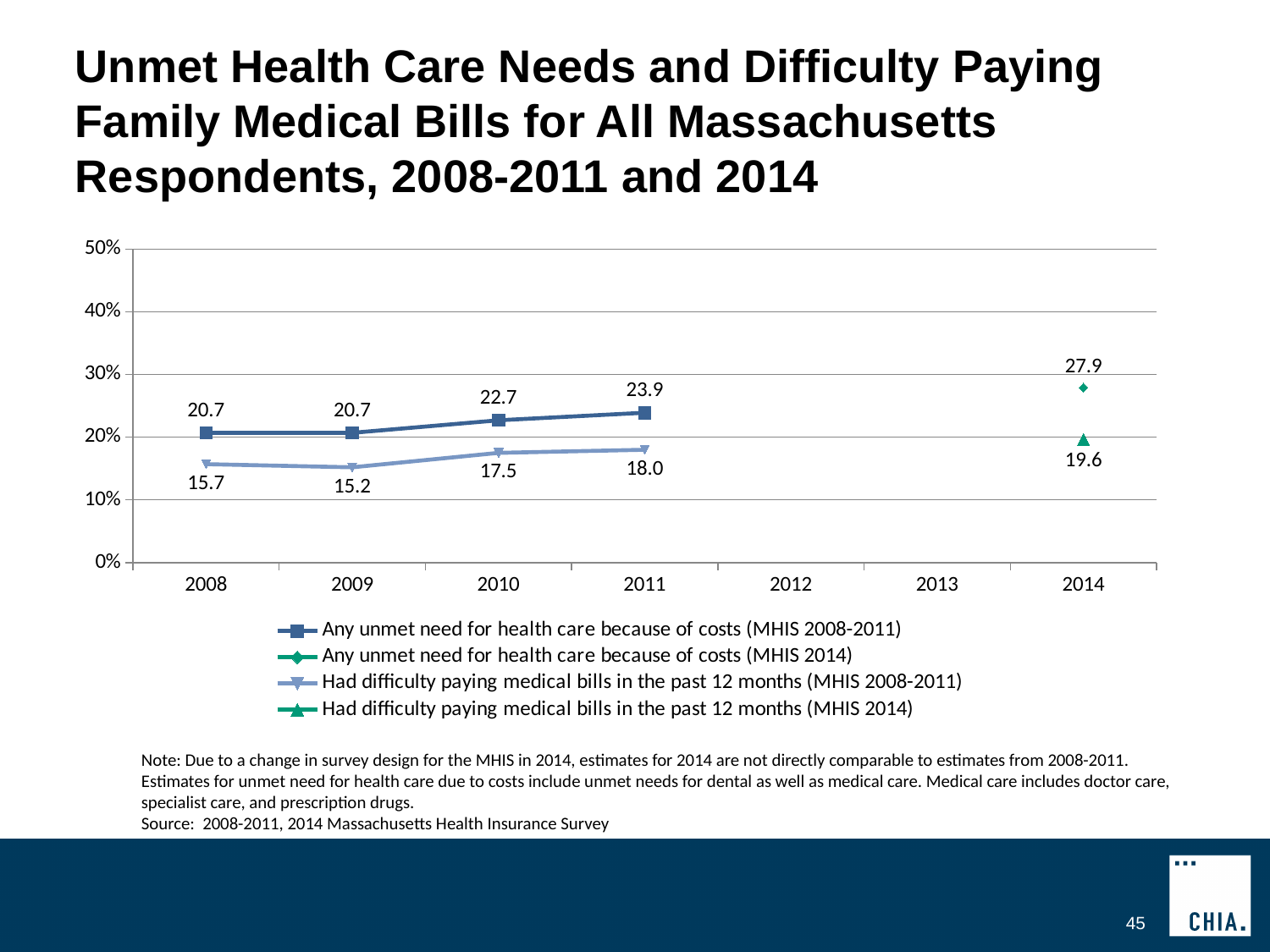
What is the value for 'Had difficulty paying medical bills in the past 12 months (MHIS 2008-2011)' in 2009? 15.2 How many series does the legend list? 4 What is the value for 'Had difficulty paying medical bills in the past 12 months (MHIS 2014)' in 2014? 19.6 What is the difference between the 'Any unmet need for health care because of costs (MHIS 2008-2011)' value and the 'Had difficulty paying medical bills in the past 12 months (MHIS 2008-2011)' value in 2011? 5.9 What is the value for 'Any unmet need for health care because of costs (MHIS 2014)' in 2014? 27.9 Does the 'Any unmet need for health care because of costs (MHIS 2008-2011)' series rise or fall from 2009 to 2011? rise In which year is the 'Any unmet need for health care because of costs (MHIS 2008-2011)' series highest? 2011 In which year is the 'Had difficulty paying medical bills in the past 12 months (MHIS 2008-2011)' series lowest? 2009 What kind of chart is shown on the slide? line chart What is the value for 'Any unmet need for health care because of costs (MHIS 2008-2011)' in 2010? 22.7 Which is larger in 2014: the value for 'Any unmet need for health care because of costs (MHIS 2014)' or the value for 'Had difficulty paying medical bills in the past 12 months (MHIS 2014)'? Any unmet need for health care because of costs (MHIS 2014) Is the value for 'Any unmet need for health care because of costs (MHIS 2014)' in 2014 greater or less than 30%? less